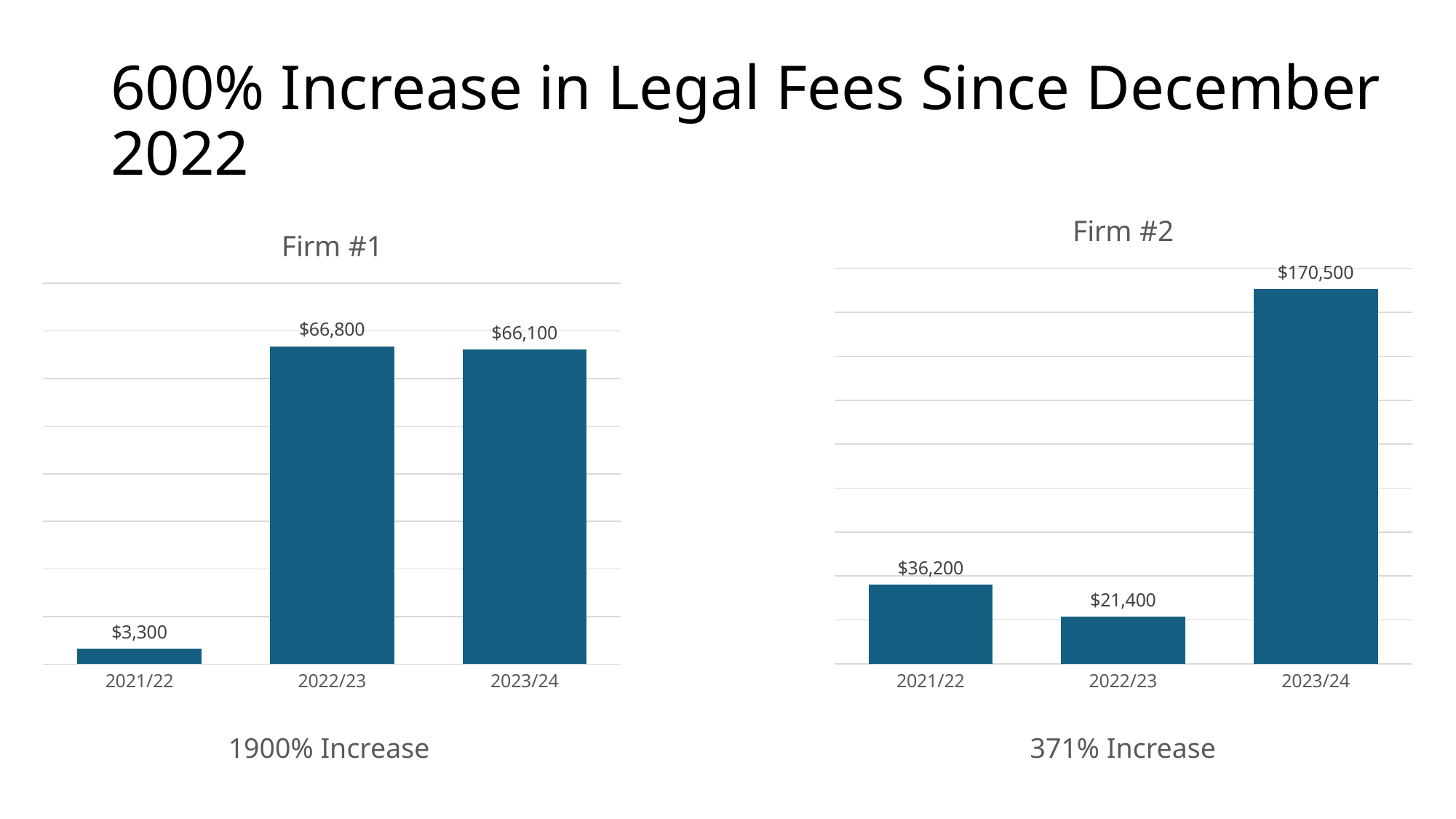
In the Firm #1 chart, what is the value for 2022/23? $66,800 In the Firm #1 chart, what is the difference between the 2022/23 and 2023/24 values? $700 What percentage increase is stated below the Firm #1 chart? 1900% Increase In the Firm #2 chart, which is larger, the value for 2021/22 or the value for 2022/23? 2021/22 In the Firm #2 chart, which year has the highest value? 2023/24 What kind of chart is the Firm #2 chart? Bar chart In the Firm #1 chart, what is the value for 2021/22? $3,300 In the Firm #1 chart, which year has the lowest value? 2021/22 In the Firm #2 chart, what is the difference between the 2021/22 and 2022/23 values? $14,800 How many categories are shown in the Firm #1 chart? 3 In the Firm #2 chart, what is the value for 2023/24? $170,500 In the Firm #2 chart, what is the value for 2022/23? $21,400